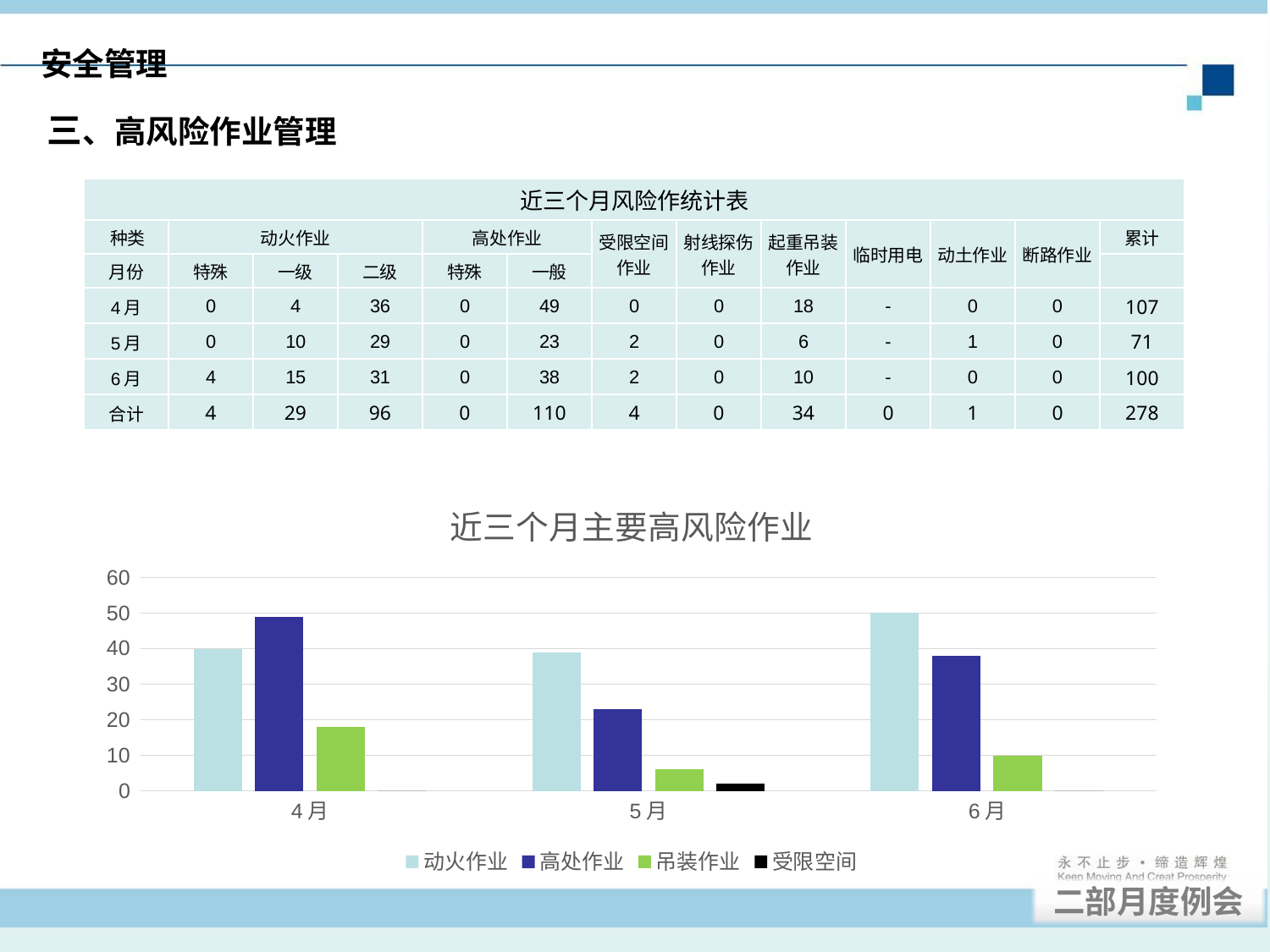
What is the title of the chart? 近三个月主要高风险作业 In which month is the 高处作业 bar the lowest? 5月 Does the 高处作业 value rise or fall from 4月 to 5月? fall How many series does the chart legend list? 4 Which legend entry is shown in black? 受限空间 Is the value for 高处作业 in 5月 greater or less than 30? less What kind of chart is shown on the slide? bar chart Is the value for 高处作业 in 6月 greater or less than 30? greater In which month is the 动火作业 bar the highest? 6月 In 4月, which is larger: 动火作业 or 高处作业? 高处作业 Is the value for 吊装作业 in 4月 greater or less than 10? greater How many months are shown on the x axis of the chart? 3